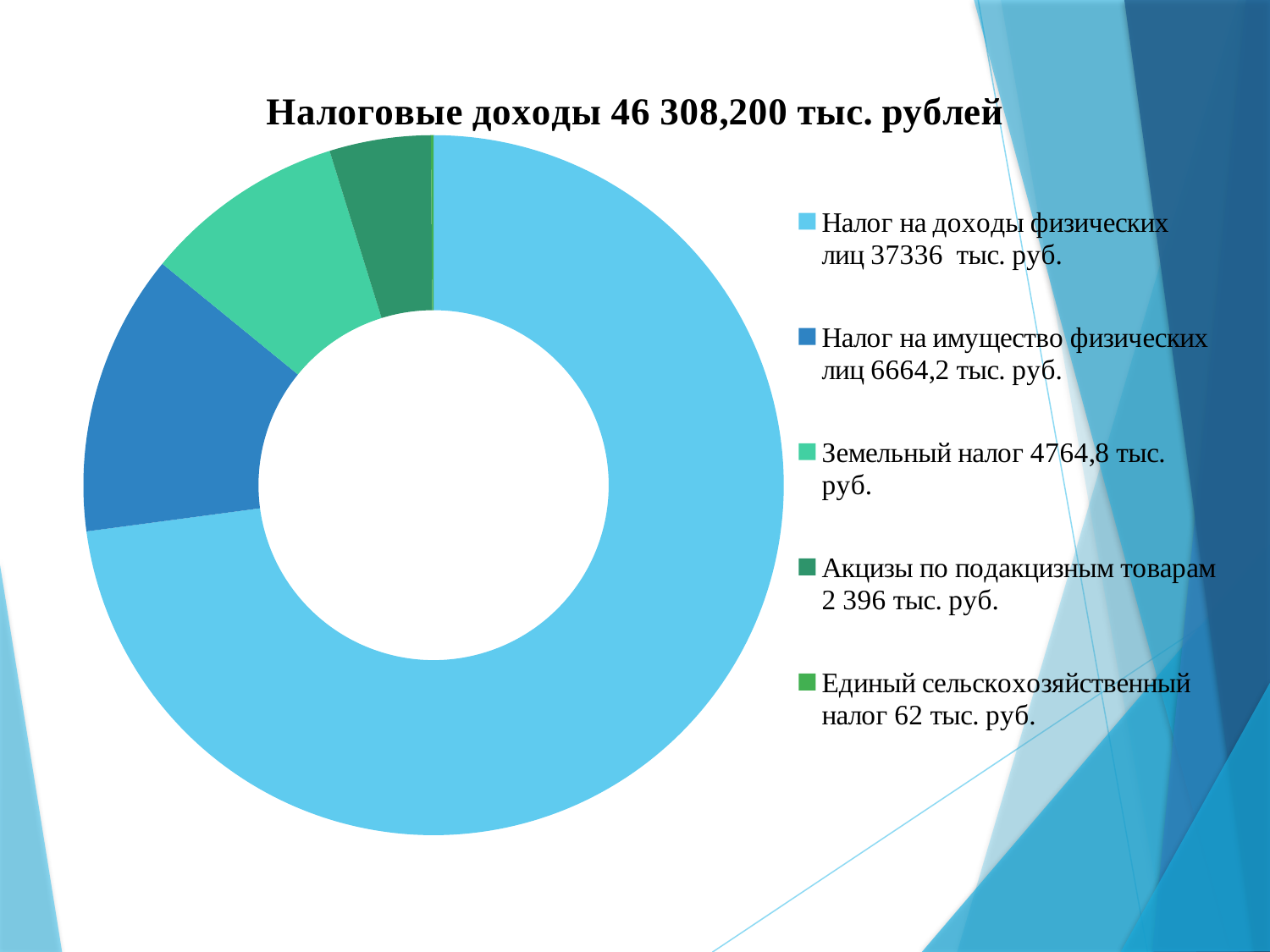
Which category has the largest value? Налог на доходы физических лиц What is the value for Акцизы по подакцизным товарам? 2 396 тыс. руб. What is the value for Единый сельскохозяйственный налог? 62 тыс. руб. What is the difference between Налог на имущество физических лиц and Земельный налог? 1899,4 тыс. руб. Which is larger: Налог на имущество физических лиц or Земельный налог? Налог на имущество физических лиц What type of chart is shown on the slide? doughnut chart What is the title of the chart? Налоговые доходы 46 308,200 тыс. рублей How many categories does the chart's legend list? 5 What is the value for Налог на имущество физических лиц? 6664,2 тыс. руб. Which category has the smallest value? Единый сельскохозяйственный налог What is the value for Налог на доходы физических лиц? 37336 тыс. руб. What is the value for Земельный налог? 4764,8 тыс. руб.